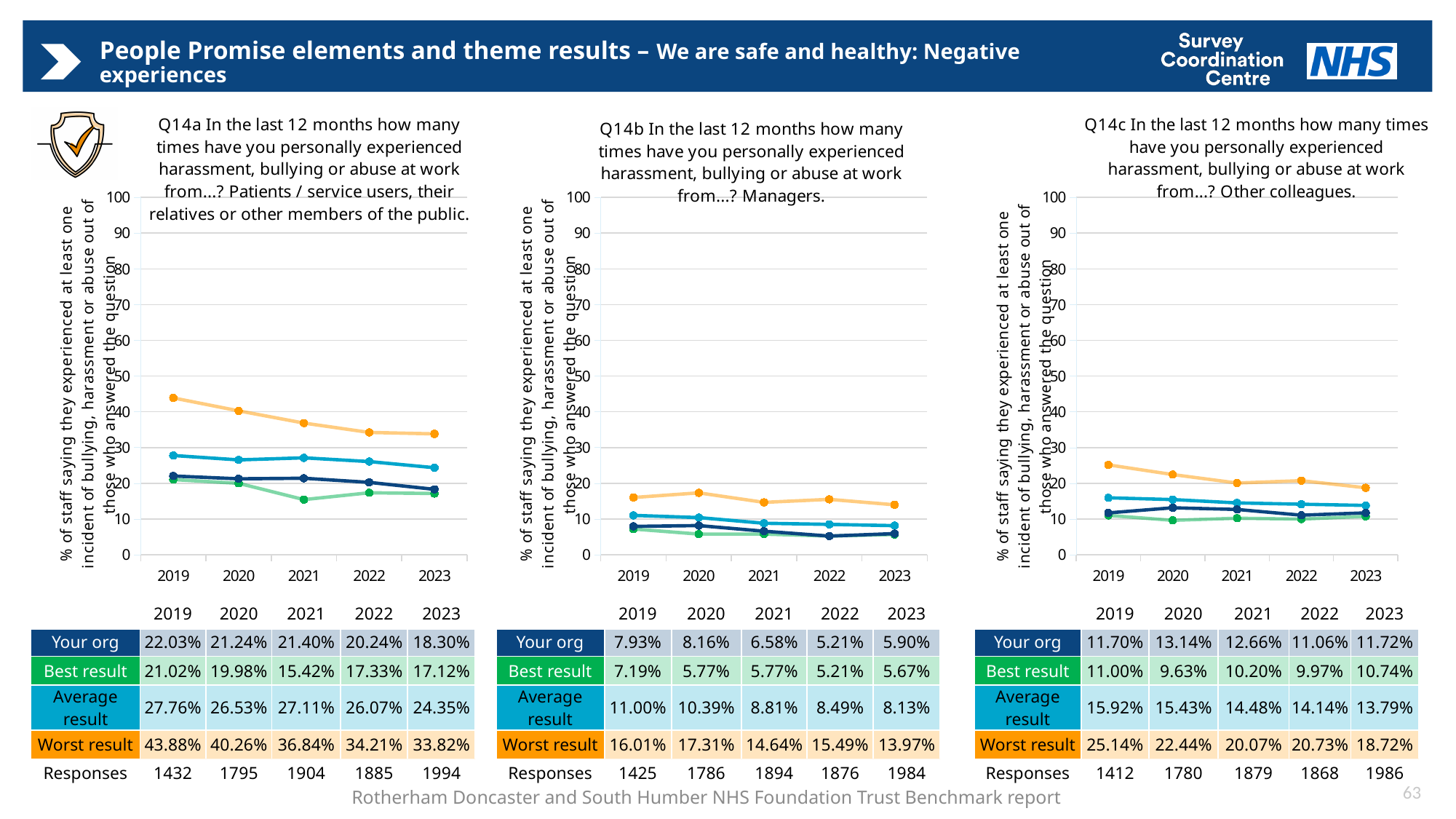
In the Q14a chart (left), what is the difference between the 'Worst result' and 'Your org' values for 2019? 21.85% In the Q14a chart (left), in which year is the 'Worst result' value highest? 2019 In the Q14c chart (right), which is larger in 2020: the 'Your org' value or the 'Best result' value? Your org In the Q14b chart (middle), in which year is the 'Your org' value lowest? 2022 How many years are plotted on the x axis of the Q14b chart (middle)? 5 In the Q14a chart (left), does the 'Worst result' line rise or fall from 2019 to 2023? Fall In the Q14b chart (middle), what is the 'Worst result' value for 2020? 17.31% What type of chart is the Q14c chart (right)? Line chart In the Q14c chart (right), what is the 'Average result' value for 2021? 14.48% In the Q14a chart (left), what is the 'Your org' value for 2023? 18.30% In the Q14b chart (middle), what colour is the 'Worst result' line? Orange In the Q14a chart (left), is the 'Worst result' value for 2019 greater or less than 40? greater